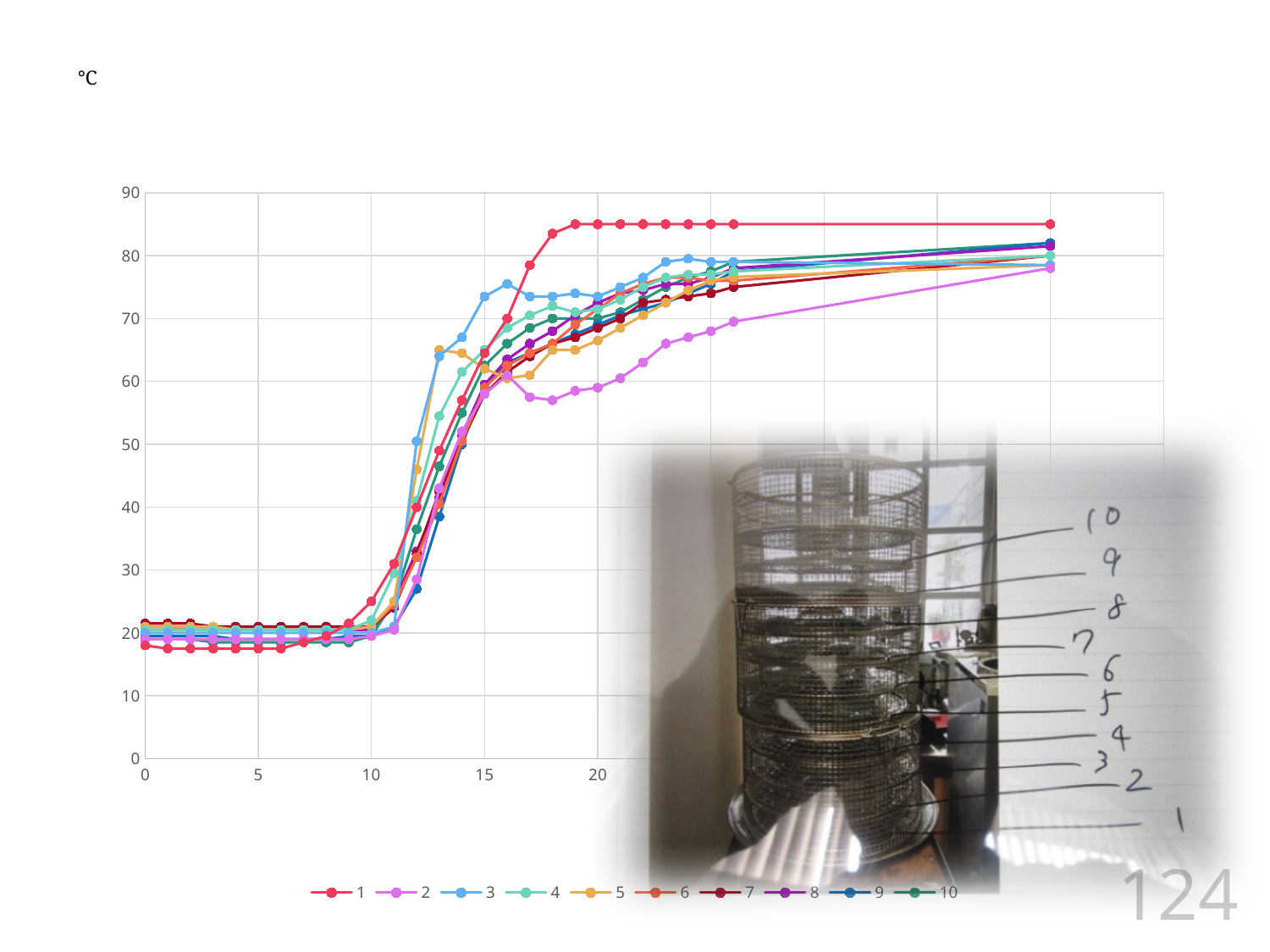
How many series does the legend list? 10 What kind of chart is shown on the slide? line chart What unit is shown for the y axis of the chart? °C What is the highest tick value shown on the y axis? 90 Do the values generally rise or fall along the x axis? rise Which series has the lowest value at x = 20? 2 Is the value for series 3 at x = 16 greater or less than 70? greater Is the value for series 1 at x = 10 greater or less than 30? less Is the value for series 2 at x = 20 greater or less than 70? less At x = 20, which is larger, the value for series 1 or the value for series 2? series 1 Which series has the highest value at x = 20? 1